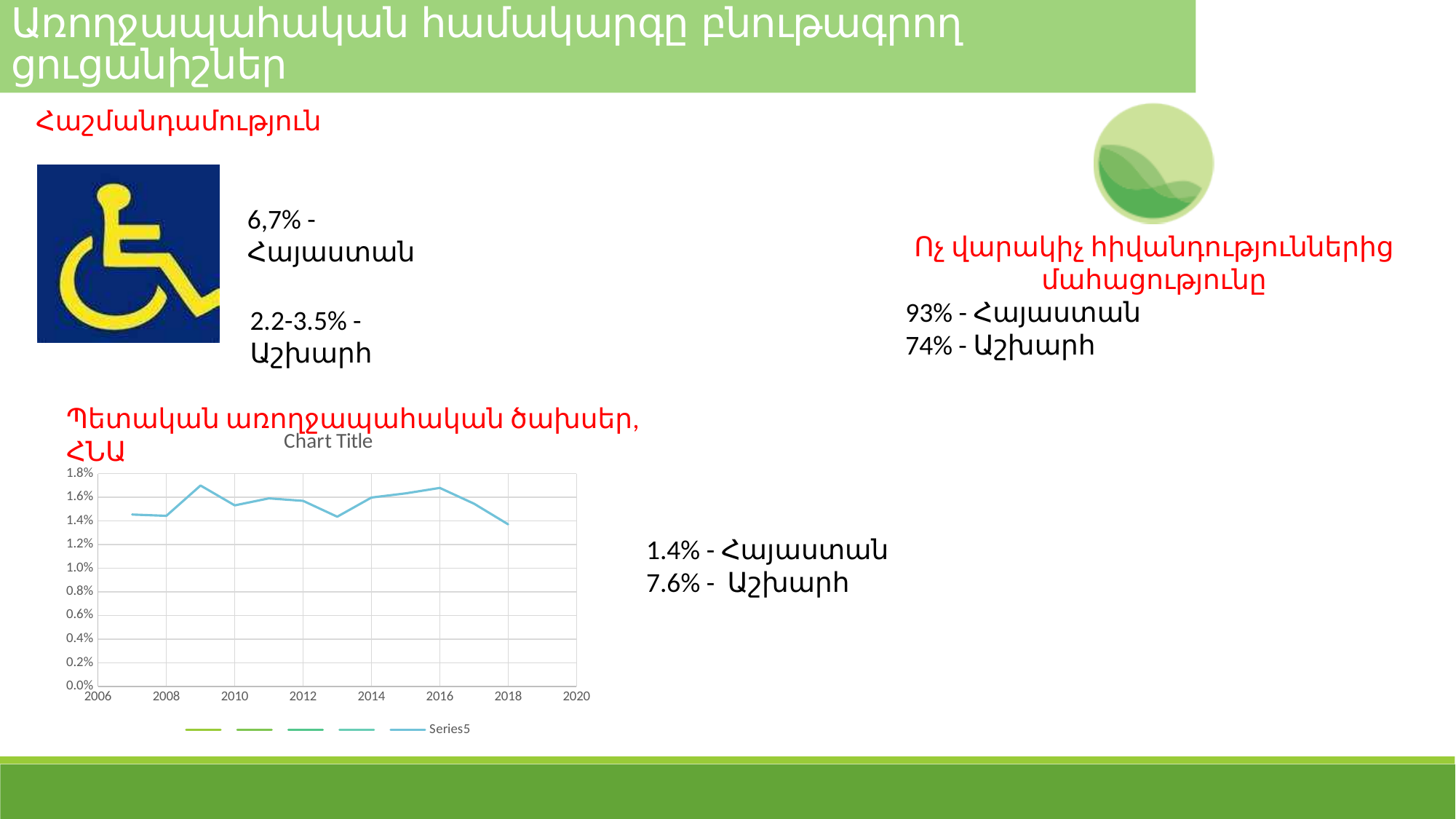
What is the title shown above the chart? Chart Title Which is larger, the value for 2016 or the value for 2018? 2016 What kind of chart is shown on the slide? line chart Is the value for 2009 greater or less than 1.6%? greater Is the value for 2013 greater or less than 1.6%? less Is the value for 2016 greater or less than 1.6%? greater Does the line rise or fall from 2016 to 2018? fall Which year has the lowest value on the line? 2018 Which is larger, the value for 2009 or the value for 2013? 2009 What is the only readable series name in the chart legend? Series5